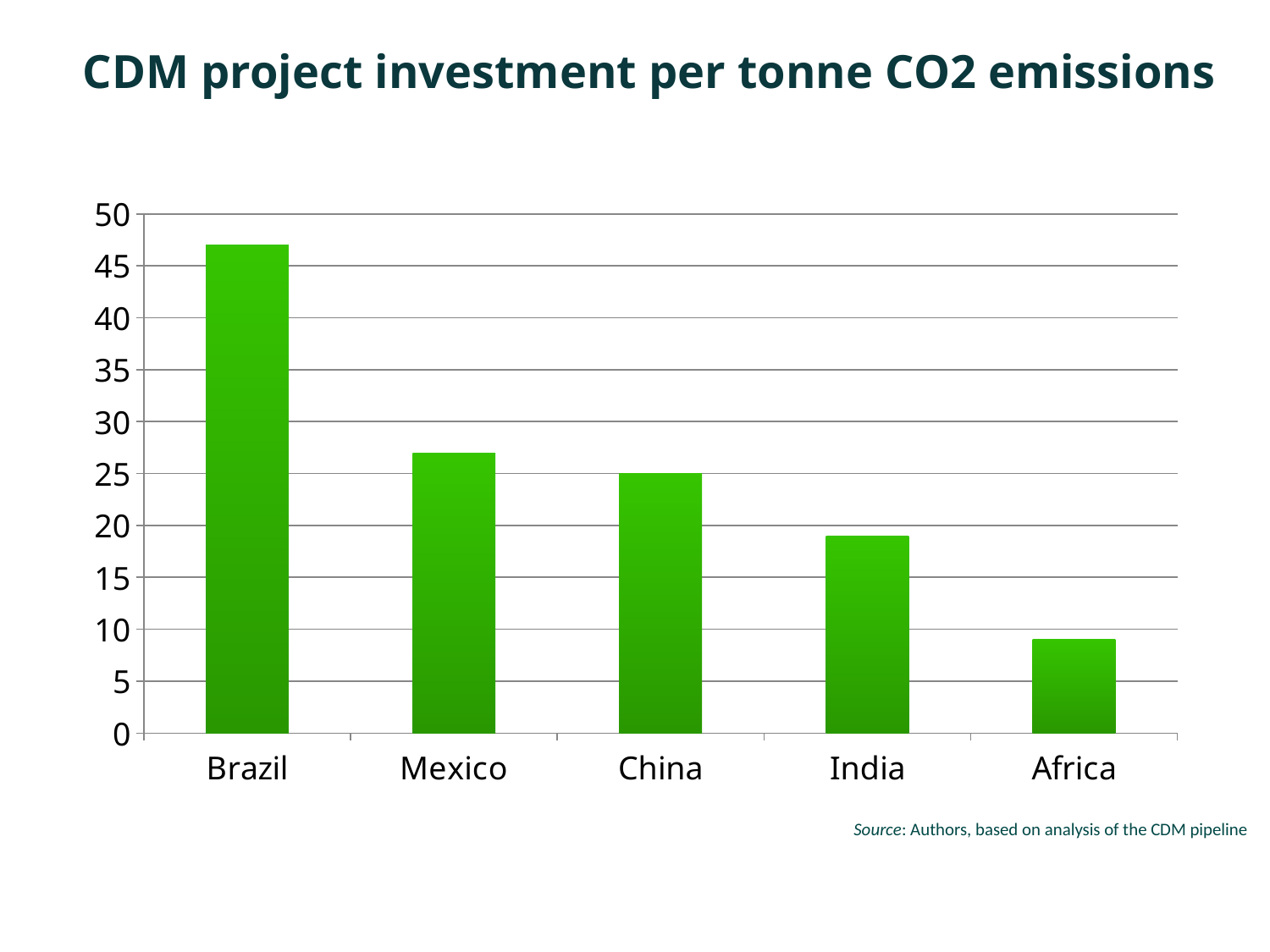
Is the value for Mexico greater or less than 25? greater What type of chart is shown on the slide? bar chart Which category has the lowest value? Africa Do the values rise or fall moving from Brazil to Africa along the x axis? fall What is the source cited below the chart? Authors, based on analysis of the CDM pipeline Is the value for India greater or less than 20? less Which category has the highest value? Brazil How many categories are shown on the x axis? 5 What is the title of the chart? CDM project investment per tonne CO2 emissions Which is larger, the value for Mexico or the value for India? Mexico Is the value for Brazil greater or less than 45? greater